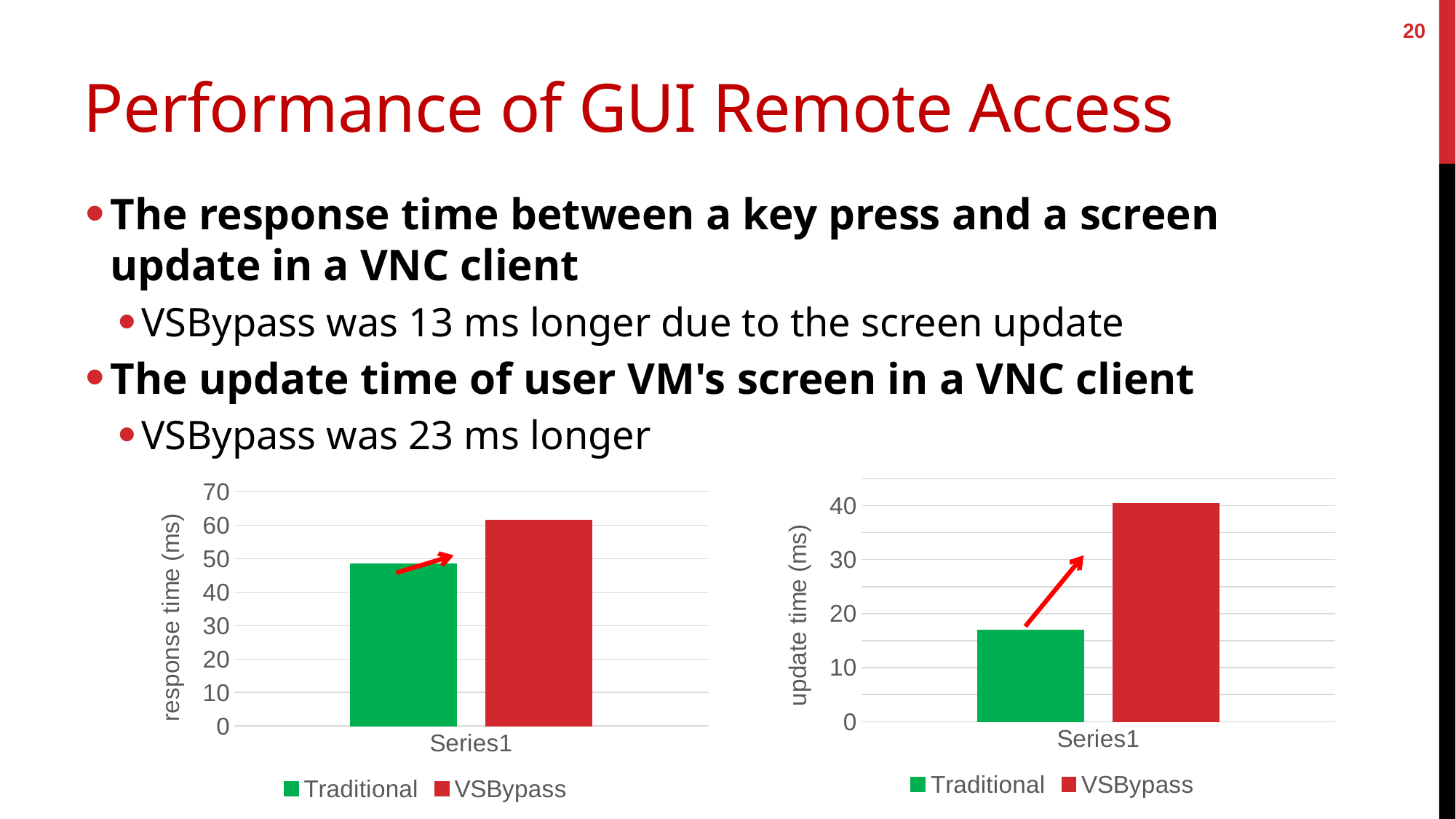
What is the y-axis label of the right chart? update time (ms) In the left chart (response time), is the value for Traditional greater or less than 40? greater In the right chart (update time), which is larger, Traditional or VSBypass? VSBypass What kind of chart is the left chart (response time)? bar chart In the left chart (response time), is the value for Traditional greater or less than 60? less In the left chart (response time), which is larger, Traditional or VSBypass? VSBypass In the right chart (update time), is the value for Traditional greater or less than 20? less How many series does the legend of the left chart list? 2 What kind of chart is the right chart (update time)? bar chart How many series does the legend of the right chart list? 2